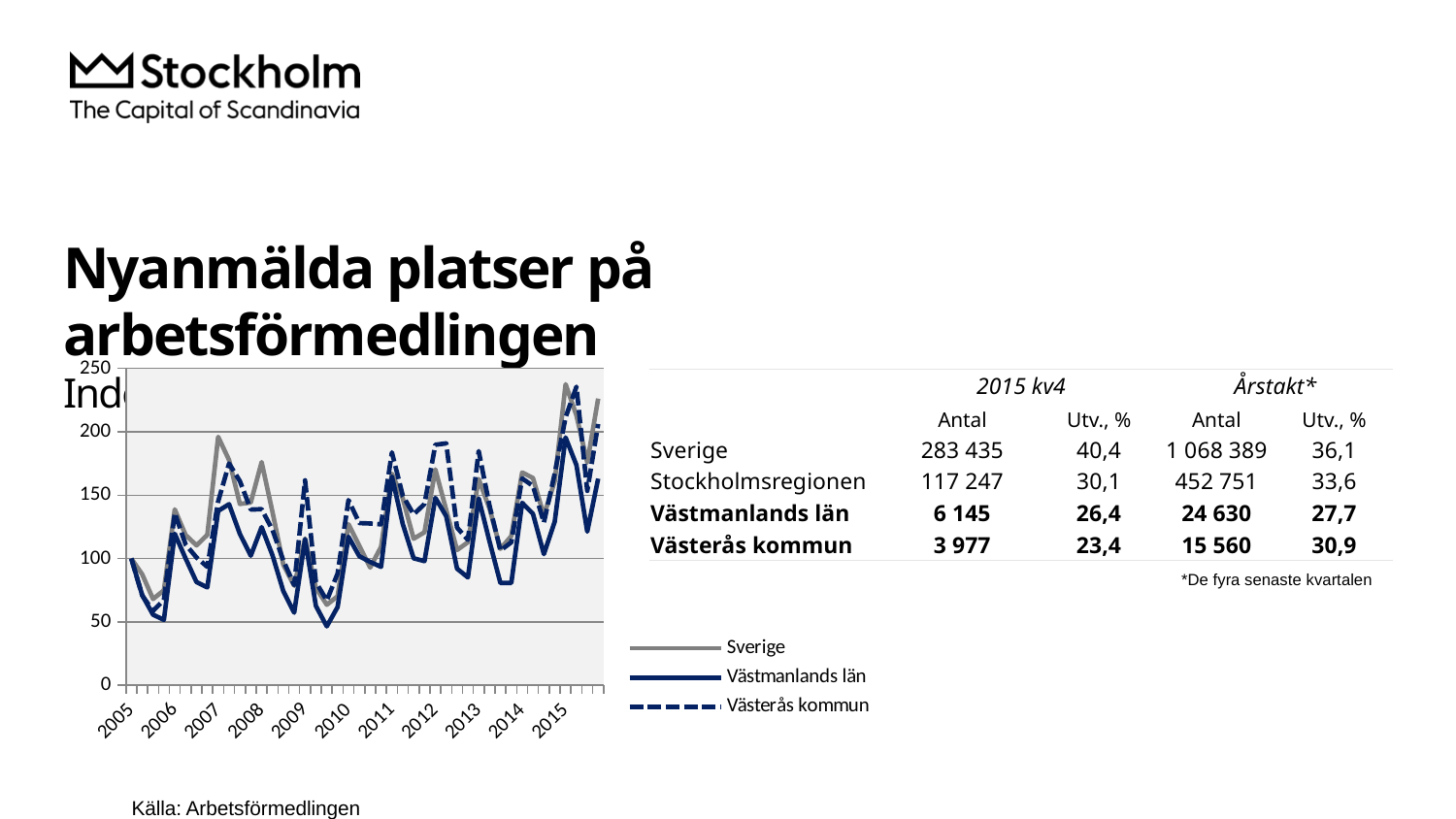
What is the highest value shown on the y axis of the chart? 250 Overall, do the values in the chart rise or fall from 2005 to 2015? Rise Is the lowest value for Västmanlands län around 2009 greater or less than 100? less Which series is drawn in grey in the chart? Sverige How many year labels are shown on the x axis of the chart? 11 Which series reaches the lowest point in the chart around 2009? Västmanlands län Is the peak value for Sverige around 2007 greater or less than 150? greater Which series is drawn with a dashed line in the chart? Västerås kommun How many series does the chart's legend list? 3 What is the last year shown on the x axis of the chart? 2015 What kind of chart is shown on the slide? Line chart What is the first year shown on the x axis of the chart? 2005